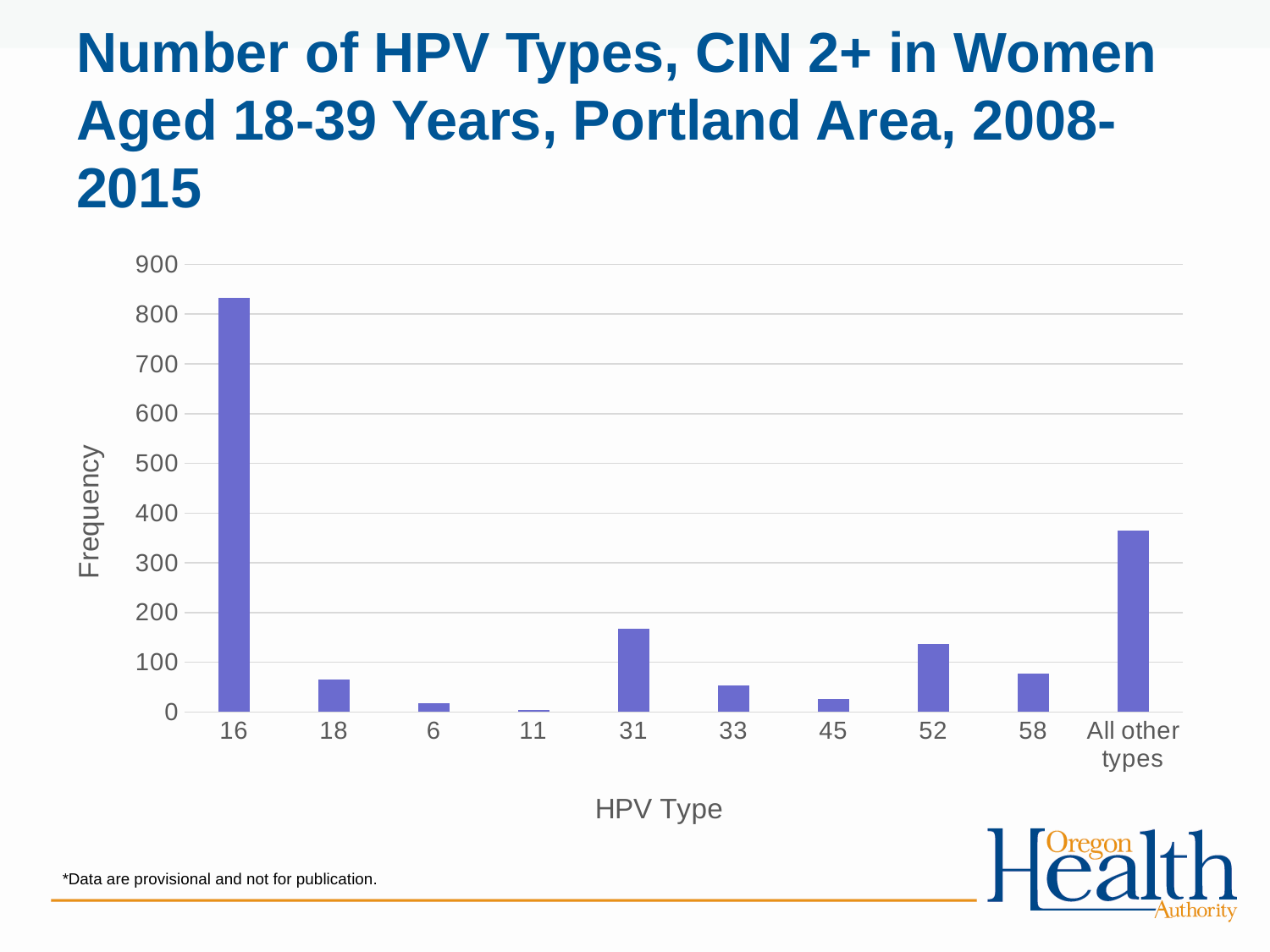
Is the frequency for HPV type 16 greater or less than 800? greater What kind of chart is shown on the slide? bar chart Which has a higher frequency, HPV type 33 or HPV type 45? 33 Is the frequency for 'All other types' greater or less than 400? less Is the frequency for 'All other types' greater or less than 300? greater Which HPV type has the lowest frequency? 11 What is the label on the y axis of the chart? Frequency How many categories are shown on the x axis? 10 Which has a higher frequency, HPV type 31 or HPV type 52? 31 Which HPV type has the highest frequency? 16